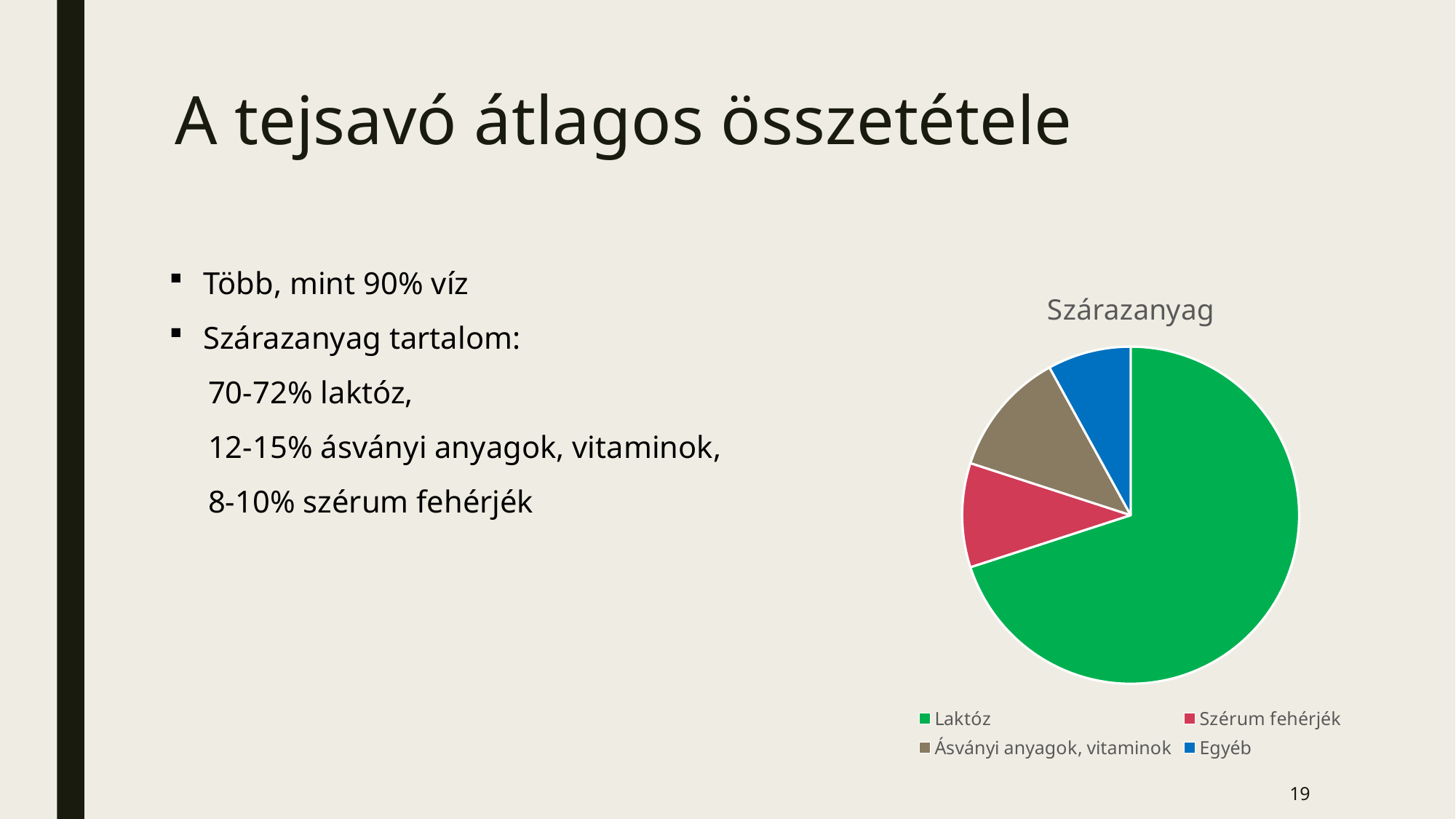
What is the title of the pie chart? Szárazanyag Which slice is larger in the pie chart, Laktóz or Ásványi anyagok, vitaminok? Laktóz What kind of chart is shown on the slide? pie chart Which slice is larger in the pie chart, Laktóz or Szérum fehérjék? Laktóz How many entries does the legend of the pie chart list? 4 How many slices does the pie chart have? 4 Which category has the largest slice in the pie chart? Laktóz Which category has the smallest slice in the pie chart? Egyéb Which slice is larger in the pie chart, Ásványi anyagok, vitaminok or Egyéb? Ásványi anyagok, vitaminok What colour is the Laktóz slice in the pie chart? green